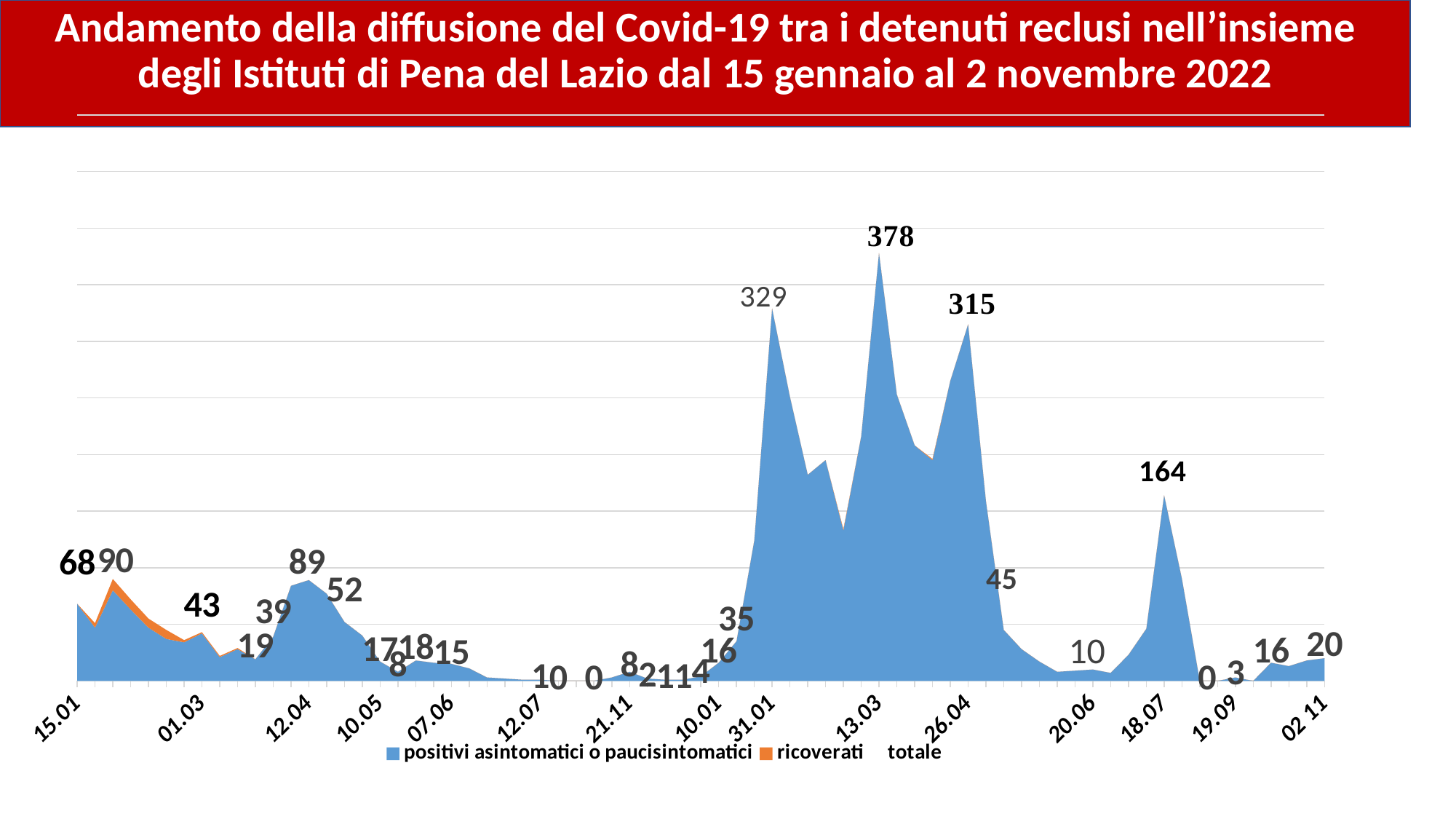
What is the value labelled at 18.07? 164 What is the value labelled at 12.04? 89 What is the value labelled at the first point, 15.01? 68 How many series does the legend list? 3 Which legend entry is shown in orange? ricoverati What is the value labelled at the 13.03 peak? 378 What is the difference between the 378 peak and the 315 peak? 63 What is the highest value labelled on the chart? 378 What is the value labelled at 31.01? 329 Which is larger, the 329 peak at 31.01 or the 315 peak at 26.04? 329 at 31.01 What kind of chart is shown on the slide? Area chart What is the value labelled at the last point, 02 11? 20